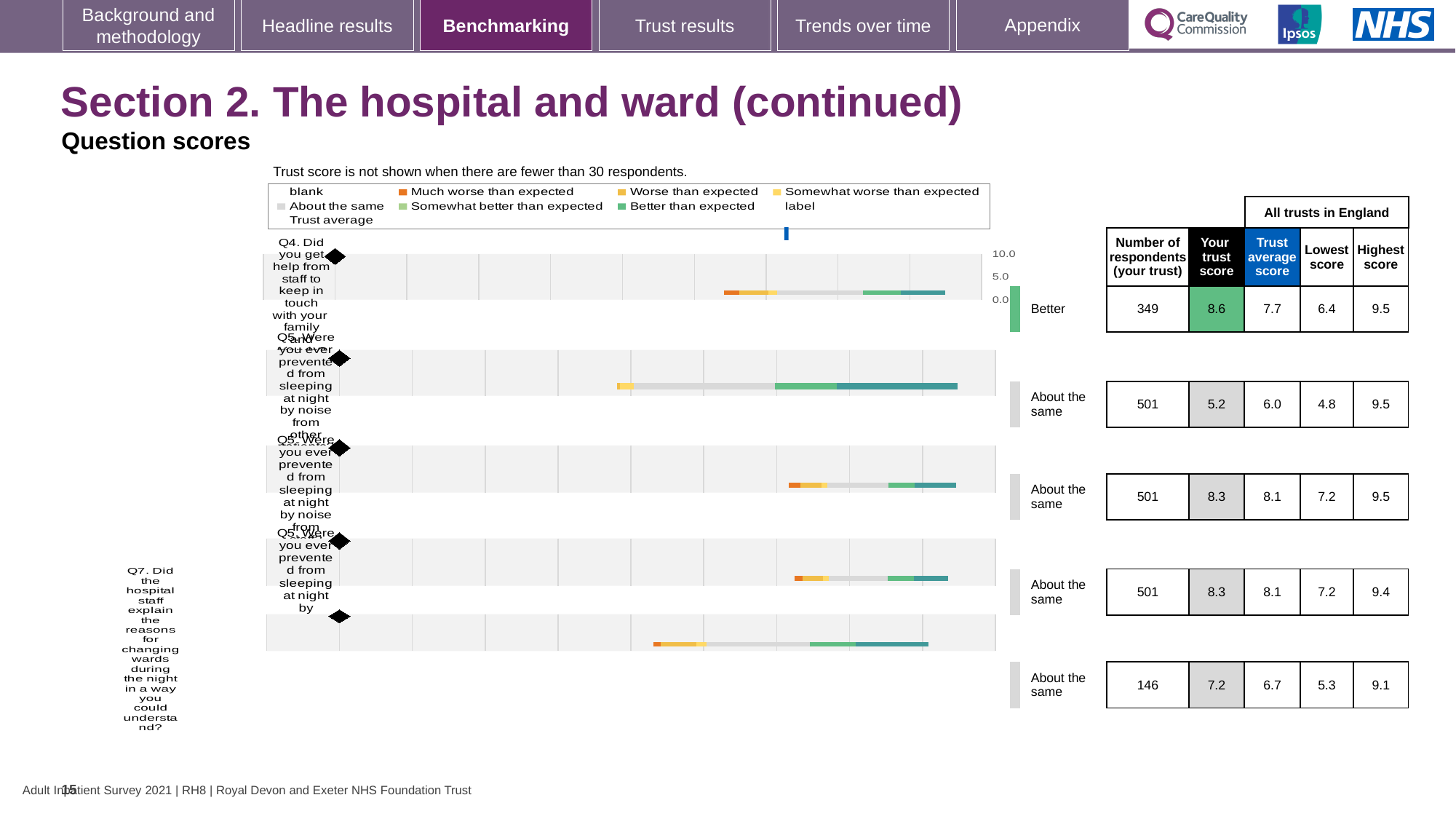
In the chart legend, what colour represents 'Much worse than expected'? orange How many question bars are plotted in the chart? 5 What benchmark category is shown next to the first (Q4) bar in the chart? Better According to the table beside the chart, what is the highest score in England for Q4 (help from staff to keep in touch with your family)? 9.5 In the chart legend, what colour represents 'About the same'? grey According to the table beside the chart, how many respondents answered Q4 (help from staff to keep in touch with your family)? 349 For Q4, which is larger: 'Your trust score' or the trust average score? Your trust score What kind of chart is used to show the question scores on this slide? bar chart Which row in the table beside the chart has the lowest 'Your trust score'? the second row (5.2) For Q4, what is the difference between 'Your trust score' and the trust average score? 0.9 According to the table beside the chart, what is the trust average score for Q4 (help from staff to keep in touch with your family)? 7.7 According to the table beside the chart, what is 'Your trust score' for Q4 (help from staff to keep in touch with your family)? 8.6